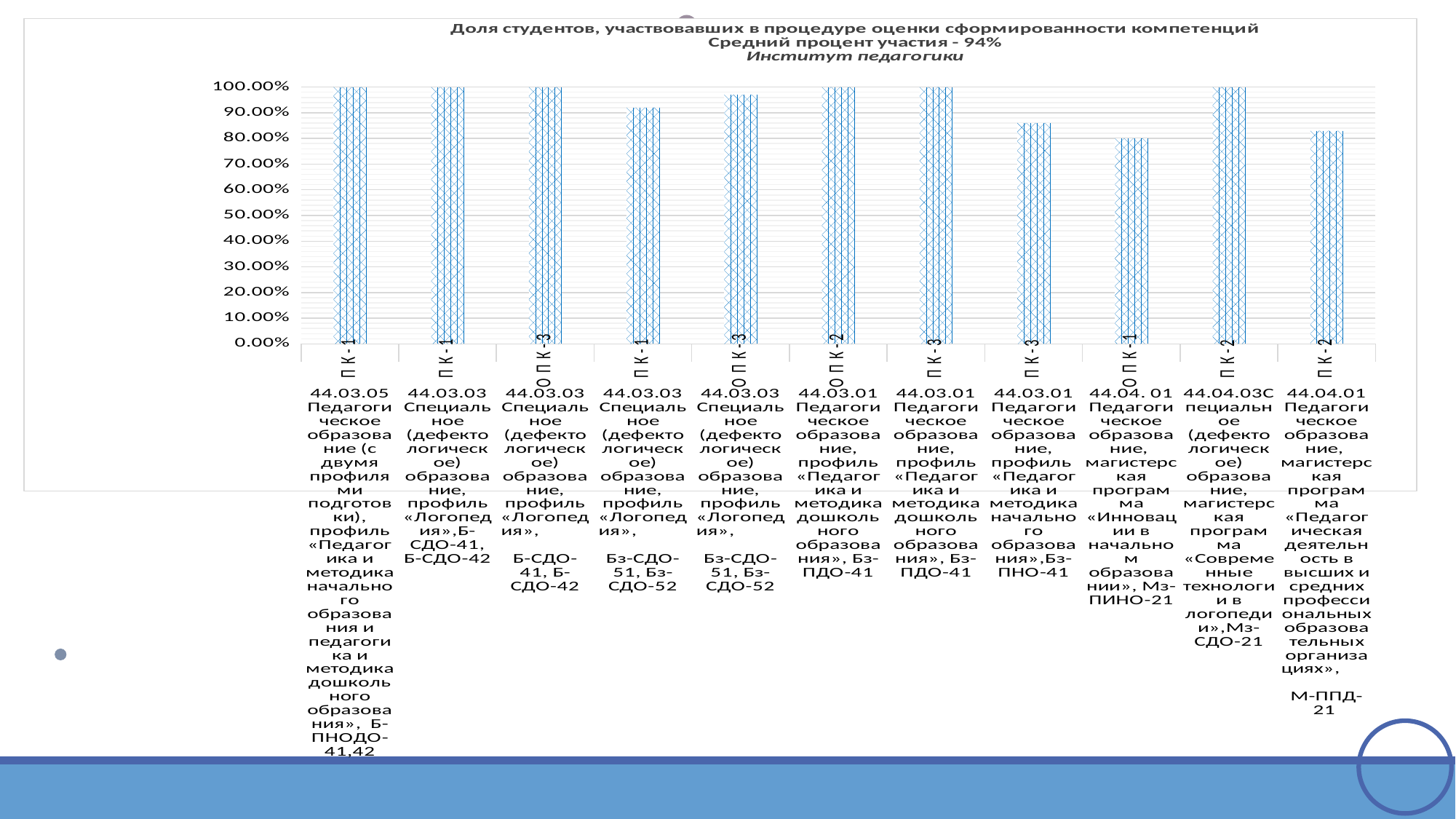
According to the chart title, what is the average participation percentage (Средний процент участия)? 94% Is the value for the group Бз-ПНО-41 (44.03.01, ПК-3) greater or less than 90%? less Is the value for the group Мз-ПИНО-21 (44.04.01, ОПК-1) greater or less than 70%? greater Is the value for the group М-ППД-21 (44.04.01, ПК-2) greater or less than 90%? less What kind of chart is shown on the slide? bar chart How many bars (categories) are plotted in the chart? 11 Which institute is named in the chart title? Институт педагогики Which has the larger value: the group Б-ПНОДО-41,42 (44.03.05, ПК-1) or the group Мз-ПИНО-21 (44.04.01, ОПК-1)? Б-ПНОДО-41,42 Which has the larger value: the group Бз-ПНО-41 (44.03.01, ПК-3) or the group Мз-СДО-21 (44.04.03, ПК-2)? Мз-СДО-21